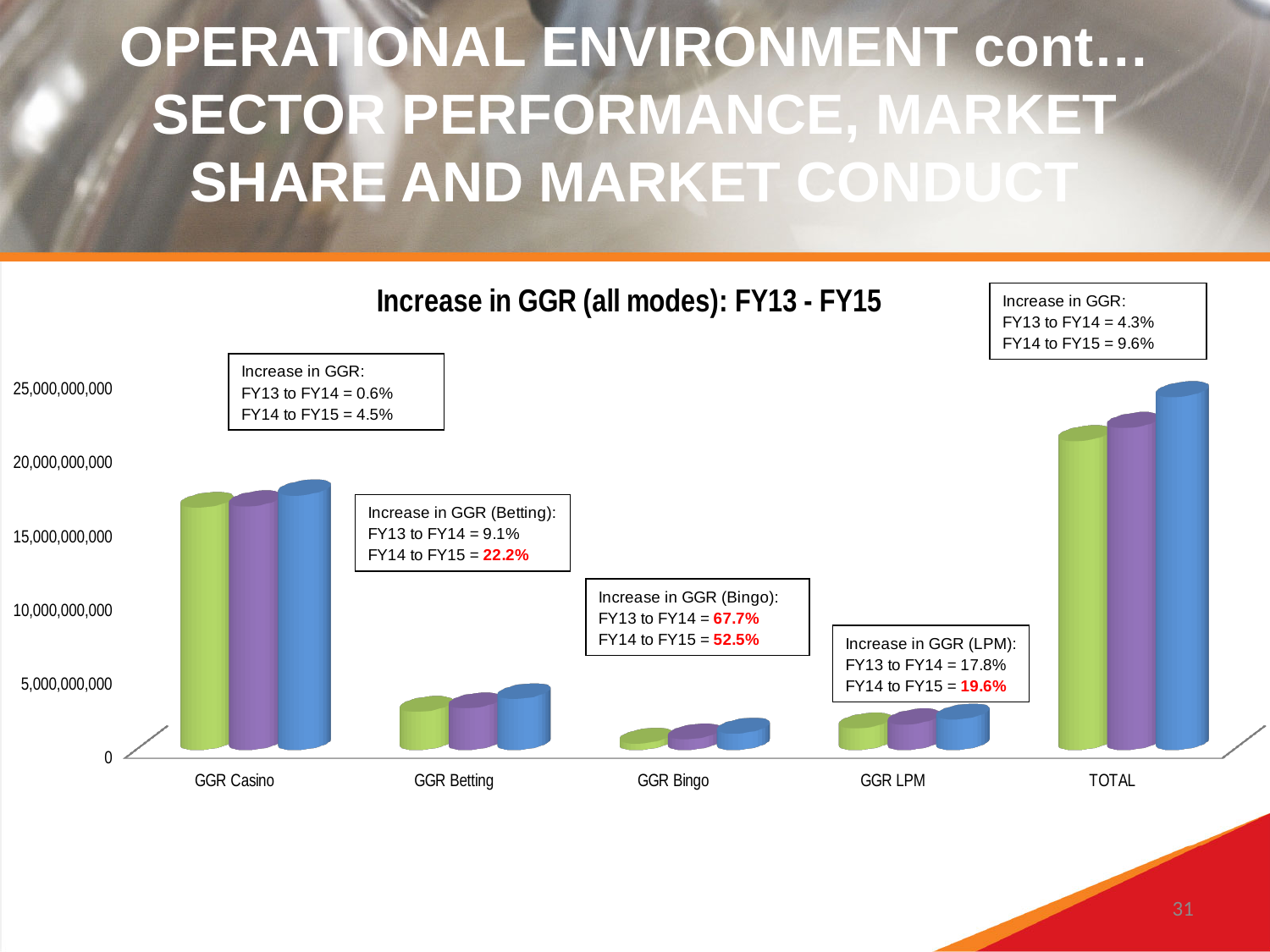
Are the bars for GGR Betting greater or less than 5,000,000,000? less According to the annotation on the chart, what was the increase in GGR (LPM) from FY14 to FY15? 19.6% Which category has larger bars, GGR Casino or GGR Betting? GGR Casino How many categories are shown on the x axis of the chart? 5 Are the bars for GGR Casino greater or less than 15,000,000,000? greater Which category has the shortest bars in the chart? GGR Bingo According to the annotation on the chart, what was the increase in GGR (Bingo) from FY13 to FY14? 67.7% Which category has the tallest bars in the chart? TOTAL According to the annotation on the chart, what was the increase in GGR (Betting) from FY14 to FY15? 22.2% Is the tallest bar for TOTAL greater or less than 20,000,000,000? greater What is the title of the chart? Increase in GGR (all modes): FY13 - FY15 What kind of chart is shown on the slide? bar chart